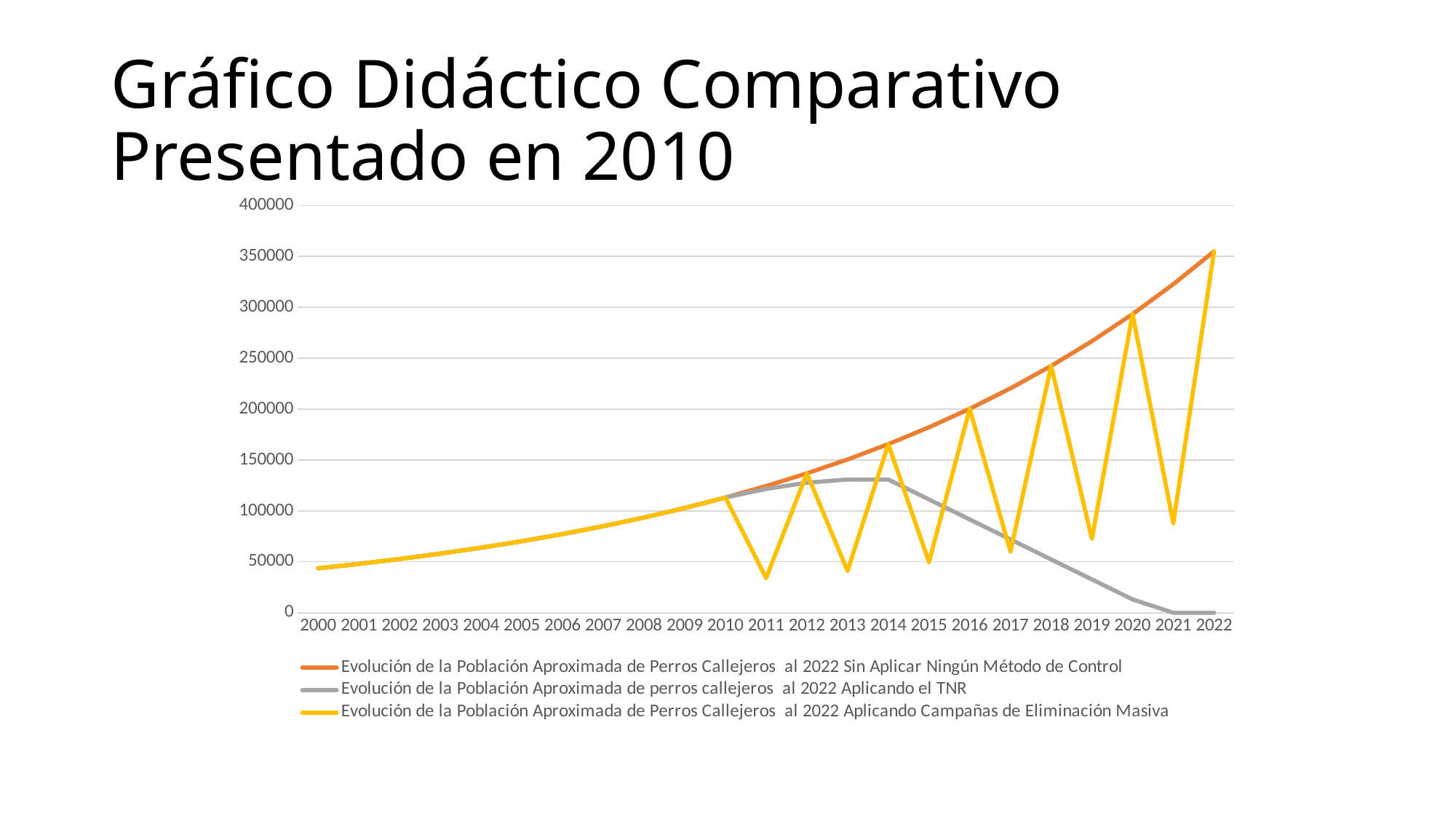
Is the 2010 value for the series 'Sin Aplicar Ningún Método de Control' greater or less than 100000? greater Is the 2022 value for the series 'Aplicando el TNR' greater or less than 50000? less In 2022, which series has the larger value: 'Sin Aplicar Ningún Método de Control' or 'Aplicando el TNR'? Sin Aplicar Ningún Método de Control What kind of chart is shown on the slide? line chart How many series does the legend list? 3 What colour is the line for the series 'Aplicando el TNR'? gray How many years are shown along the x axis? 23 In 2019, which series has the larger value: 'Aplicando el TNR' or 'Aplicando Campañas de Eliminación Masiva'? Aplicando Campañas de Eliminación Masiva Does the series 'Aplicando el TNR' rise or fall from 2014 to 2022? fall In which year does the series 'Sin Aplicar Ningún Método de Control' reach its highest value? 2022 Is the 2022 value for the series 'Sin Aplicar Ningún Método de Control' greater or less than 300000? greater